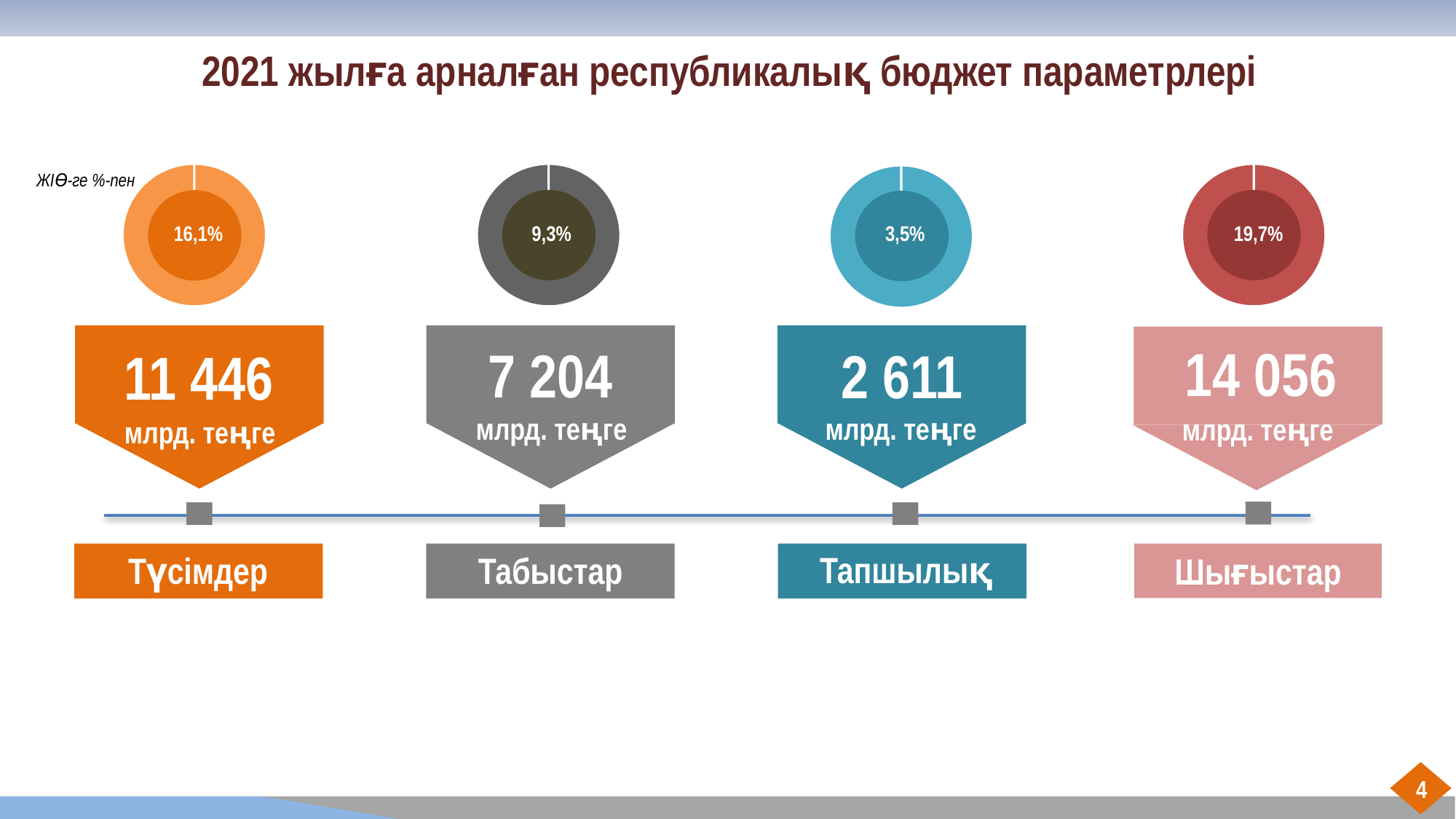
Which of the four donut charts shows the lowest percentage? Тапшылық (3,5%) Which of the four donut charts shows the highest percentage? Шығыстар (19,7%) What colour is the donut chart above the Шығыстар label? Red What value in млрд. теңге is shown below the blue donut chart for Тапшылық? 2 611 What kind of chart is used to display the percentages on the slide? Donut (pie) chart Which donut chart shows a larger percentage, Табыстар or Тапшылық? Табыстар How many donut charts are shown on the slide? 4 What is the difference between the percentage in the Шығыстар donut chart and the percentage in the Түсімдер donut chart? 3,6% What percentage is shown in the blue donut chart above Тапшылық? 3,5% What percentage is shown in the centre of the orange donut chart above Түсімдер? 16,1% What percentage is shown in the grey donut chart above Табыстар? 9,3% What percentage is shown in the red donut chart above Шығыстар? 19,7%